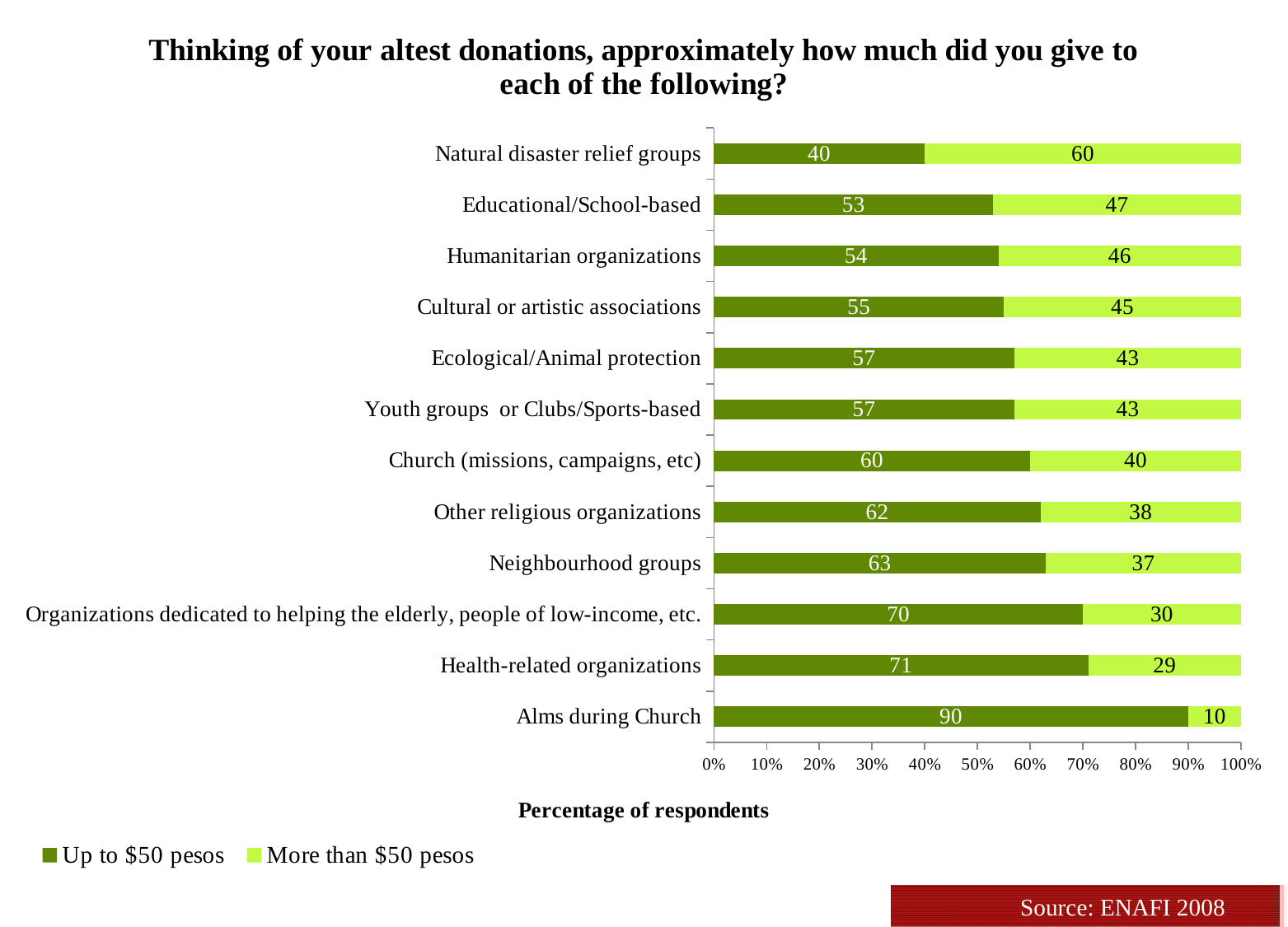
Which category has the highest value for 'Up to $50 pesos'? Alms during Church What kind of chart is shown on the slide? Stacked bar chart Which category has the lowest value for 'More than $50 pesos'? Alms during Church What percentage of respondents gave more than $50 pesos to Health-related organizations? 29 How many series does the legend list? 2 How many categories are shown on the chart? 12 Which category has the highest value for 'More than $50 pesos'? Natural disaster relief groups What is the difference between the 'Up to $50 pesos' values for Alms during Church and Health-related organizations? 19 Which is larger: the 'Up to $50 pesos' value for Church (missions, campaigns, etc) or for Educational/School-based? Church (missions, campaigns, etc) What is the total of the stacked bar for Humanitarian organizations? 100 What percentage of respondents gave up to $50 pesos to Natural disaster relief groups? 40 What is the value for 'Up to $50 pesos' for Neighbourhood groups? 63